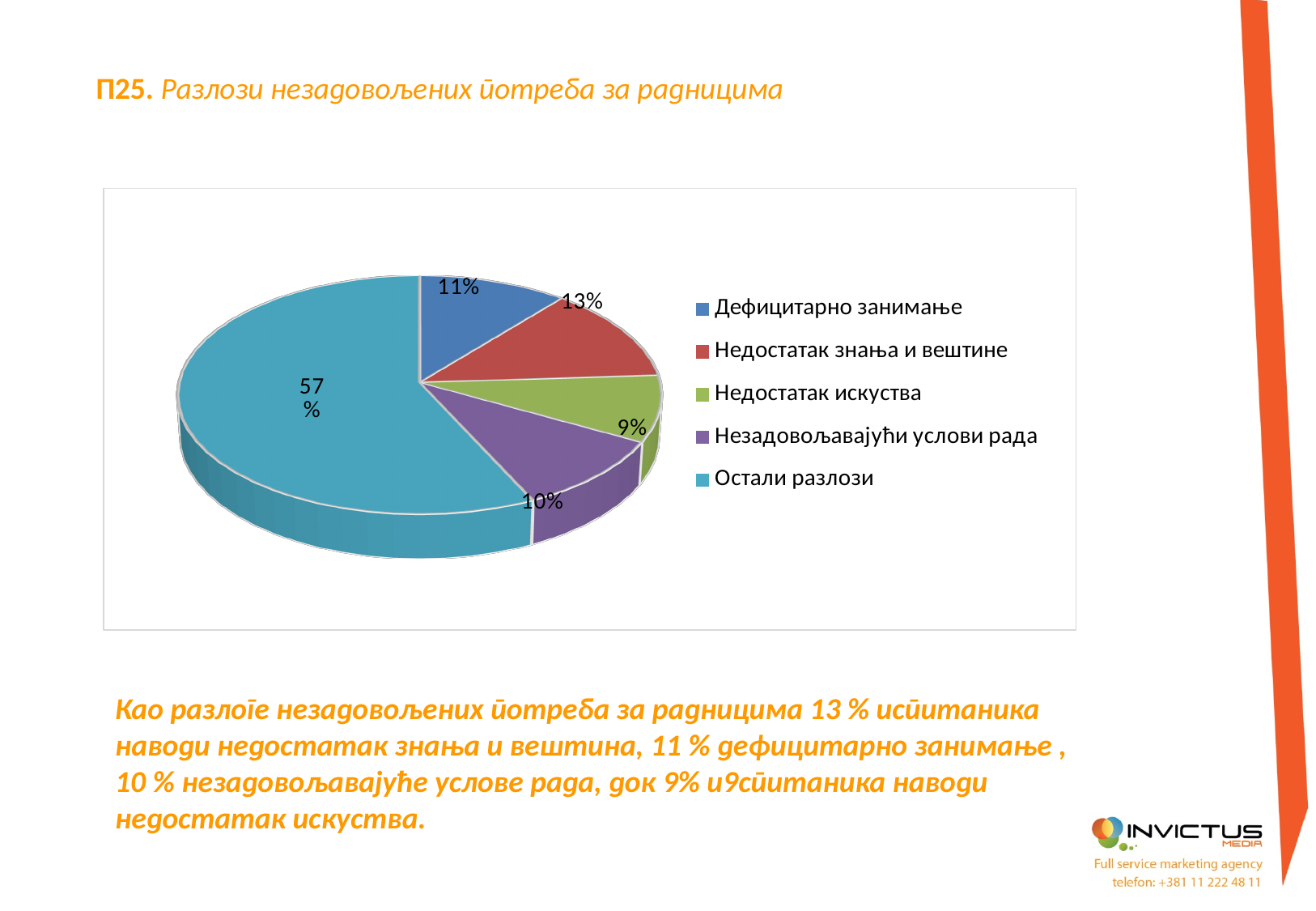
How many categories does the legend list? 5 What kind of chart is shown on the slide? pie chart What is the value for "Дефицитарно занимање"? 11% What colour is the slice for "Остали разлози"? light blue Which category has the smallest slice of the pie? Недостатак искуства What is the value for "Недостатак знања и вештине"? 13% What is the value for "Недостатак искуства"? 9% What is the value for "Незадовољавајући услови рада"? 10% What share of the pie does "Остали разлози" take? 57% Which is larger: the share for "Дефицитарно занимање" or for "Незадовољавајући услови рада"? Дефицитарно занимање What is the difference between the shares of "Недостатак знања и вештине" and "Недостатак искуства"? 4% Which category has the largest slice of the pie? Остали разлози